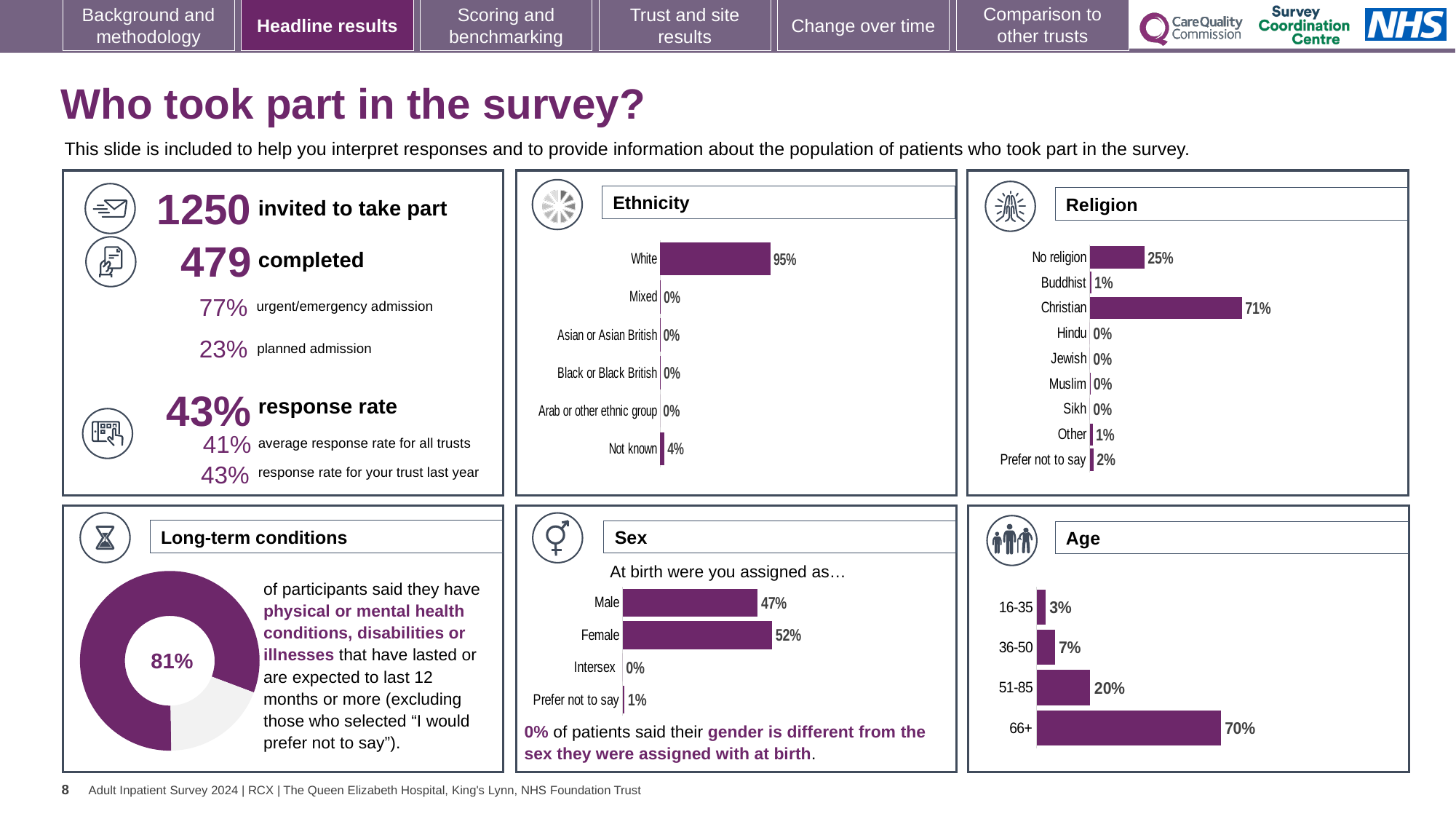
In the Long-term conditions chart, what share of participants said they have physical or mental health conditions, disabilities or illnesses? 81% In the Age chart, what is the value for the 51-85 age group? 20% In the Age chart, do the values rise or fall as the age groups increase from 16-35 to 66+? rise In the Age chart, which age group has the highest value? 66+ In the Religion chart, what is the difference between the Christian and No religion values? 46% In the Religion chart, which religion category has the highest value? Christian In the Religion chart, what is the value for No religion? 25% In the Sex chart, which is larger, Male or Female? Female In the Sex chart, what is the difference between the Female and Male values? 5% In the Ethnicity chart, what percentage of respondents were White? 95% In the Religion chart, how many religion categories are shown? 9 In the Ethnicity chart, what percentage of respondents had ethnicity Not known? 4%